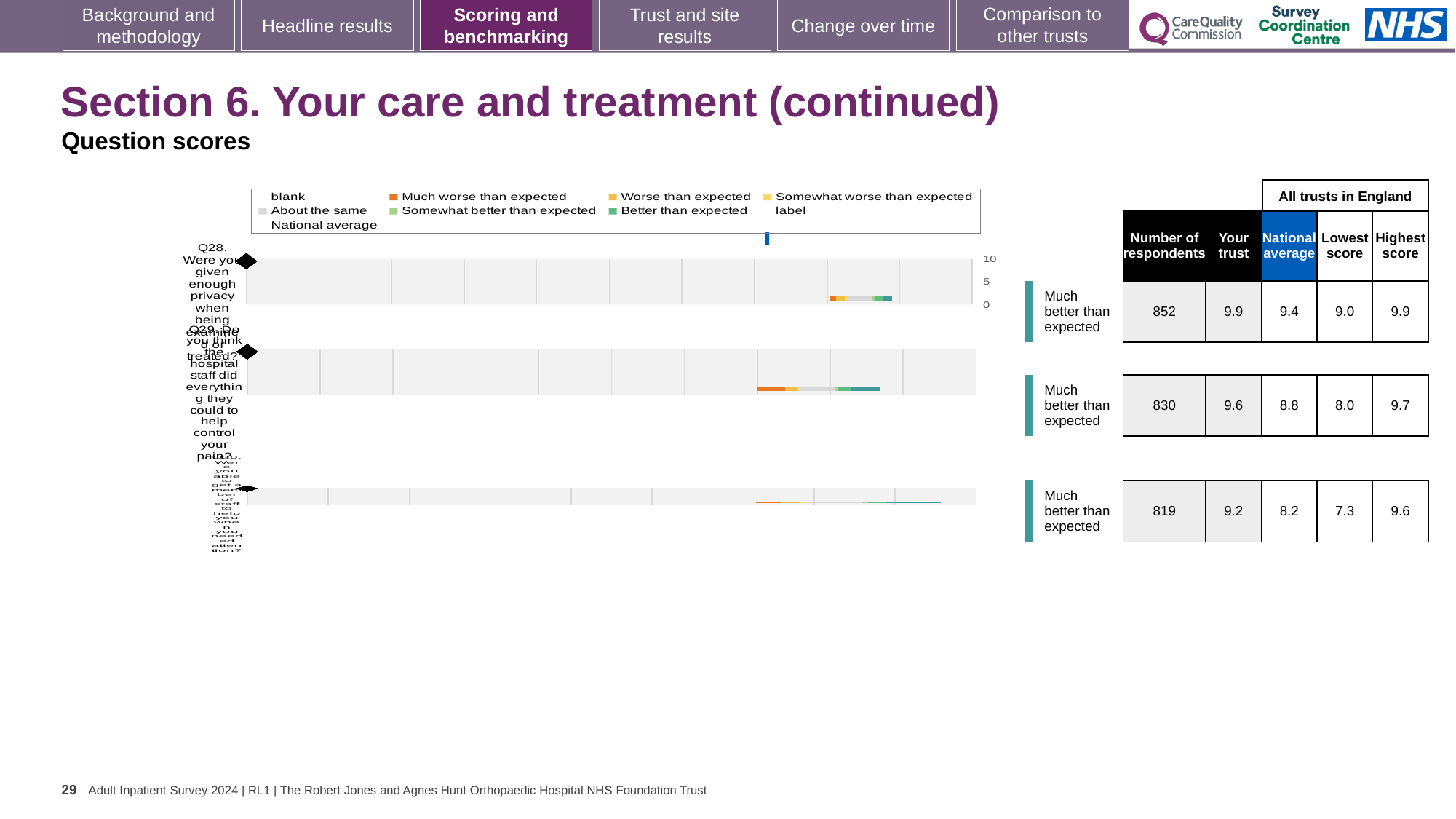
For the Q29 chart (staff did everything to help control your pain), what is the Lowest score among all trusts in England? 8.0 Across the three question charts, which question has the highest Your trust score? Q28 How many entries does the chart legend list? 9 For the Q28 chart, which is larger: the Your trust score or the National average? Your trust For the Q28 chart (privacy when being examined or treated), what is the score for Your trust? 9.9 What kind of chart is used for the question scores? Bar chart Across the three question charts, which question has the lowest National average score? The third (bottom) question, Q30 For the third (bottom) question chart, what is the Highest score among all trusts in England? 9.6 For the Q29 chart, what is the difference between the Your trust score and the National average? 0.8 For the Q28 chart (privacy when being examined or treated), what is the National average score? 9.4 For the Q29 chart (staff did everything to help control your pain), what is the score for Your trust? 9.6 How many question charts are shown on the slide? 3